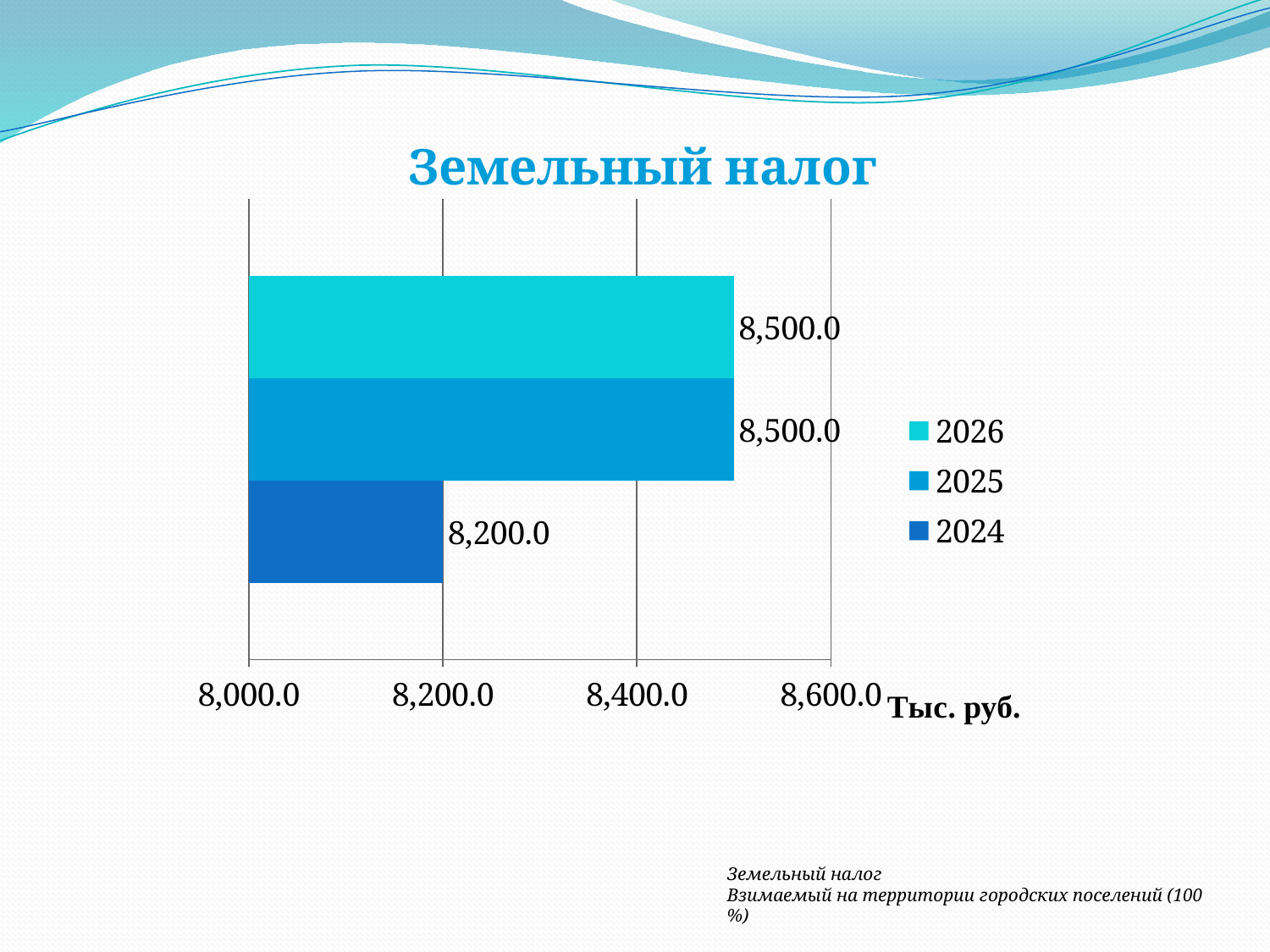
What unit label is shown next to the horizontal axis? Тыс. руб. What is the value for 2025? 8,500.0 Is the value for 2024 greater or less than 8,400.0? less What is the difference between the values for 2025 and 2024? 300.0 What kind of chart is shown on the slide? bar chart What is the value for 2026? 8,500.0 What is the value for 2024? 8,200.0 How many series does the legend list? 3 Which is larger, the value for 2024 or the value for 2026? 2026 What is the title of the chart? Земельный налог Which year has the lowest value? 2024 Is the value for 2025 greater or less than 8,400.0? greater